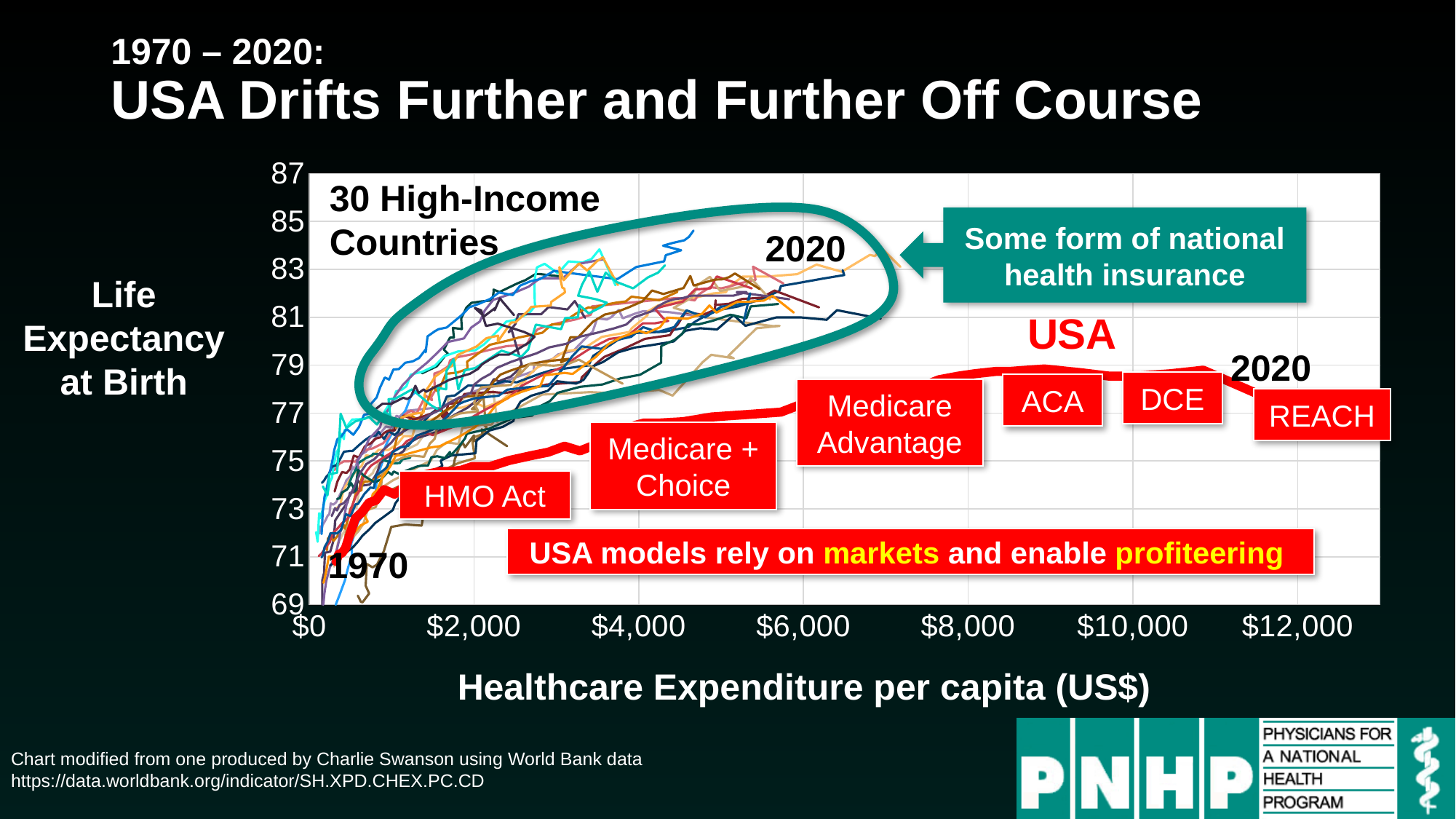
What is the label of the x axis? Healthcare Expenditure per capita (US$) How many USA policy labels (HMO Act, Medicare + Choice, etc.) are marked along the USA line? 6 Is the USA's life expectancy at birth in 2020 greater or less than 79? less Is the USA's life expectancy at birth in 1970 greater or less than 73? less In 2020, which has the higher life expectancy at birth: the USA or the group of 30 high-income countries? the 30 high-income countries What kind of chart is shown on the slide? line chart Is the healthcare expenditure per capita of the 30 high-income countries in 2020 greater or less than $8,000? less Does life expectancy at birth generally rise or fall as healthcare expenditure per capita increases along the x axis? rise What is the title of the slide's chart? 1970 – 2020: USA Drifts Further and Further Off Course How many high-income countries does the chart say are plotted alongside the USA? 30